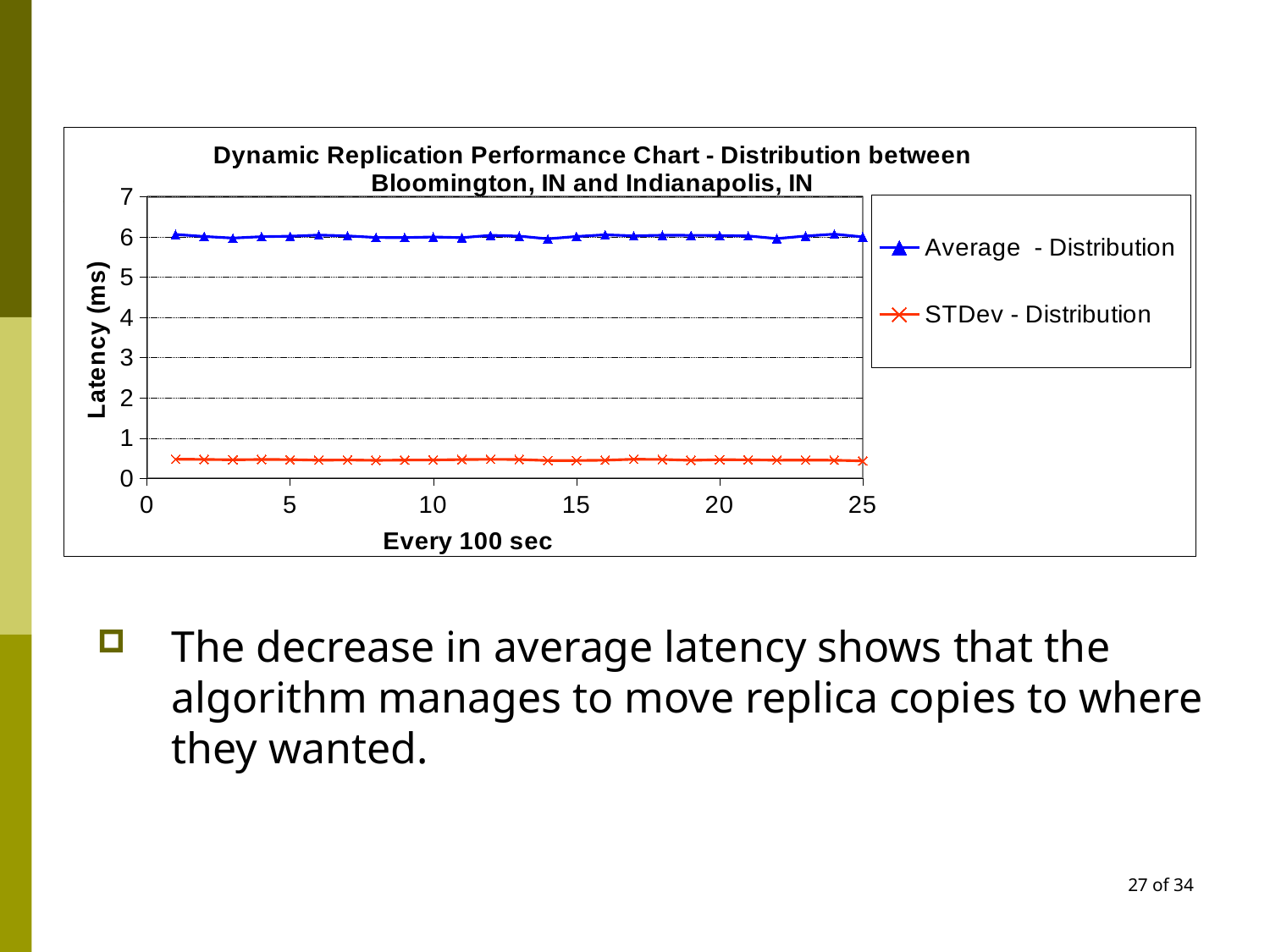
How many series does the chart's legend list? 2 What is the label of the chart's y axis? Latency (ms) Which series is plotted with the lowest values on the chart? STDev - Distribution Is the value of the STDev - Distribution series greater or less than 2 ms? less Does the Average - Distribution series rise, fall, or stay roughly flat along the x axis? stays roughly flat Which series has the higher latency values, Average - Distribution or STDev - Distribution? Average - Distribution What is the label of the chart's x axis? Every 100 sec Is the value of the STDev - Distribution series greater or less than 1 ms? less What kind of chart is shown on the slide? line chart Is the value of the Average - Distribution series greater or less than 5 ms? greater